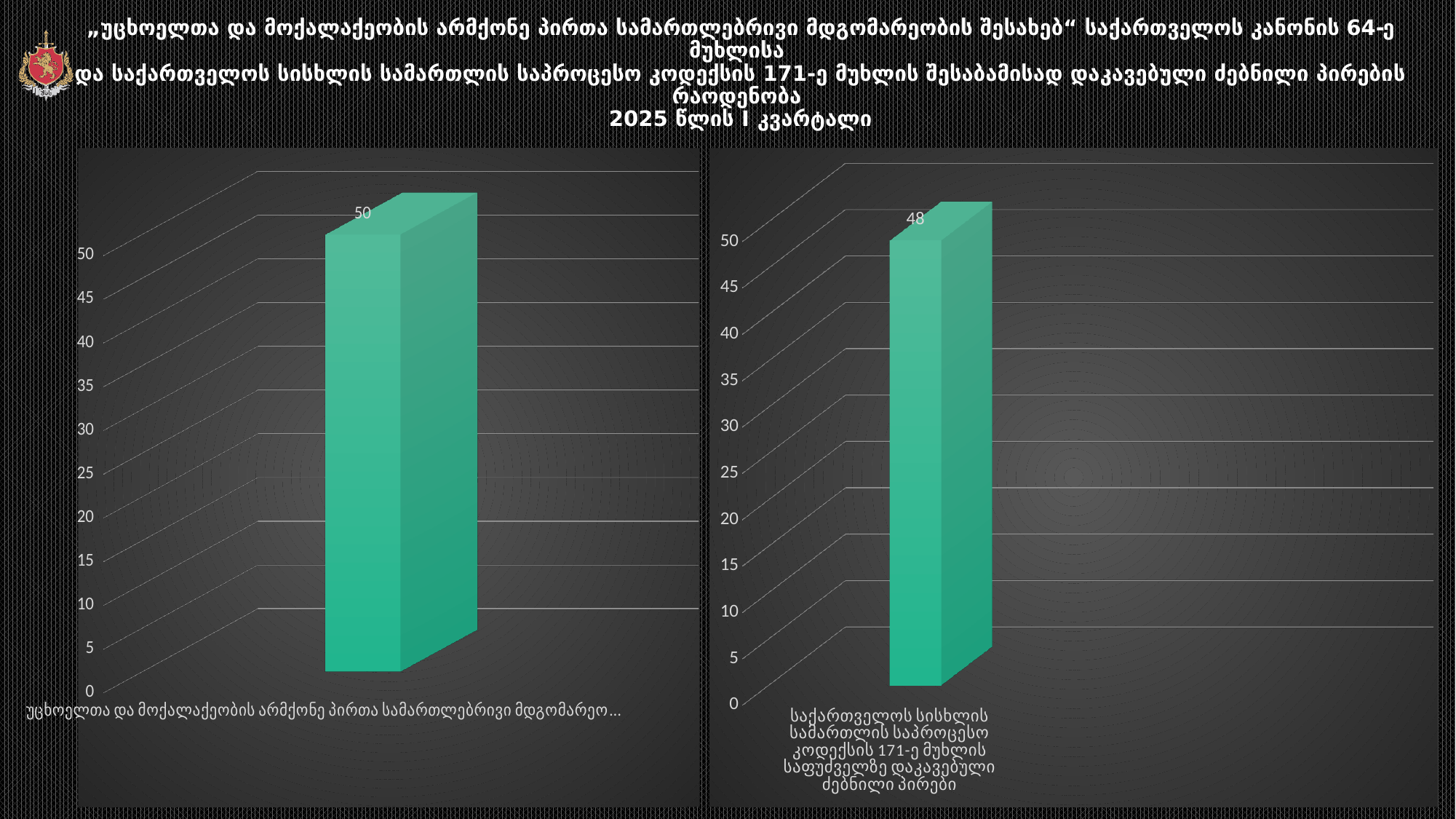
Which is larger: the value on the left chart or the value on the right chart? the left chart (50) What kind of chart is the right chart? bar chart On the right chart, is the value of the bar greater or less than 45? greater Which quarter and year does the slide title say the data refers to? 2025 წლის I კვარტალი How many bars does the left chart show? 1 How many bars does the right chart show? 1 What kind of chart is the left chart? bar chart On the left chart, what is the value of the bar? 50 What is the difference between the value on the left chart and the value on the right chart? 2 On the left chart, is the value of the bar greater or less than 40? greater What is the highest tick value shown on the vertical axis of the left chart? 50 On the right chart, what is the value of the bar for persons detained under Article 171 of the Criminal Procedure Code of Georgia? 48